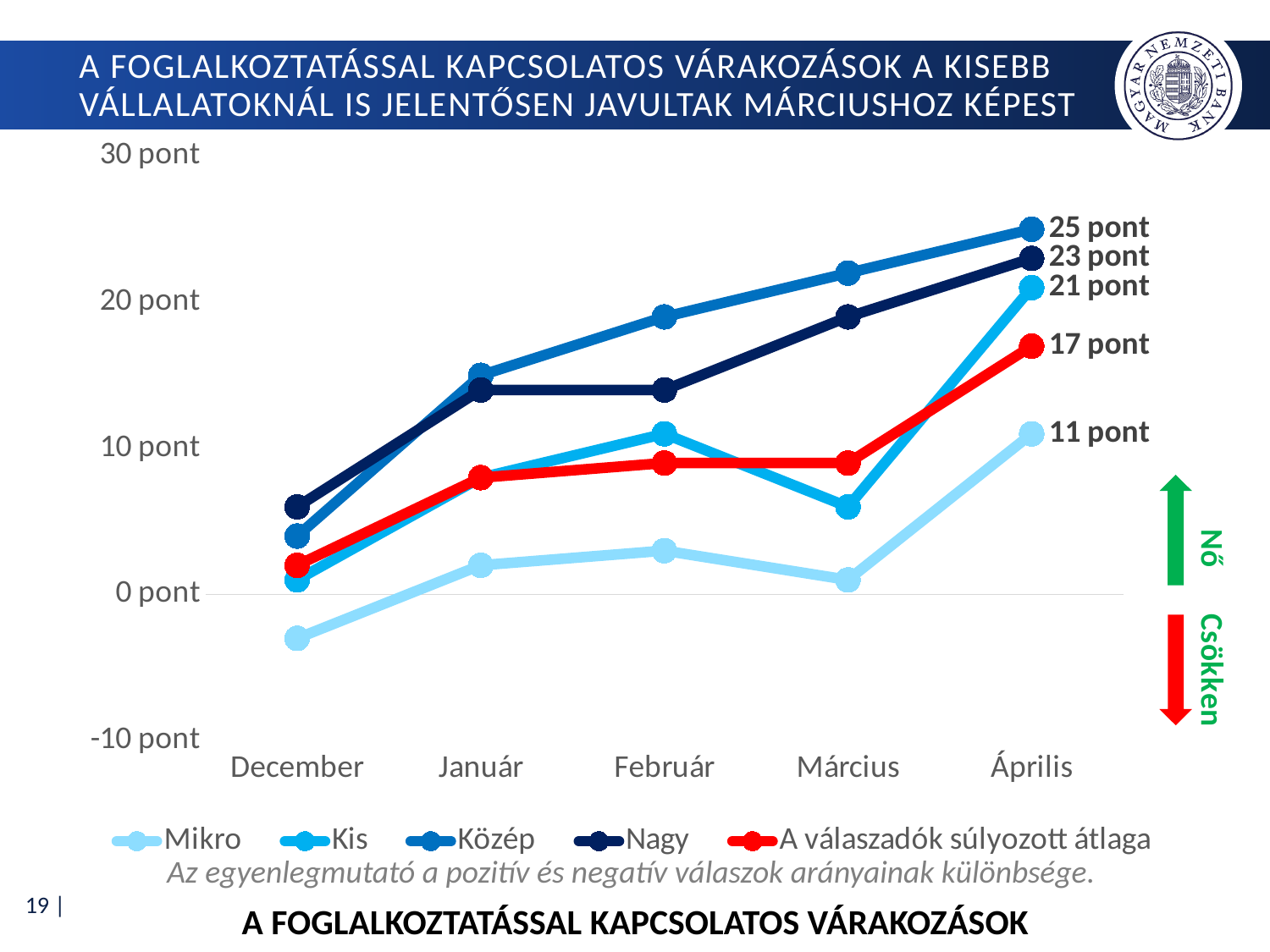
Is the value for Mikro in December greater or less than 0 pont? less Which series has the lowest value in Április? Mikro What is the value for A válaszadók súlyozott átlaga in Április? 17 pont How many months are shown on the x axis? 5 What kind of chart is shown on the slide? line chart What is the value for Közép in Április? 25 pont Which series has the highest value in Április? Közép Which is larger in Április, the value for Kis or the value for Mikro? Kis What is the difference between the Közép and Mikro values in Április? 14 pont What is the value for Mikro in Április? 11 pont What is the value for Nagy in Április? 23 pont How many series does the legend list? 5